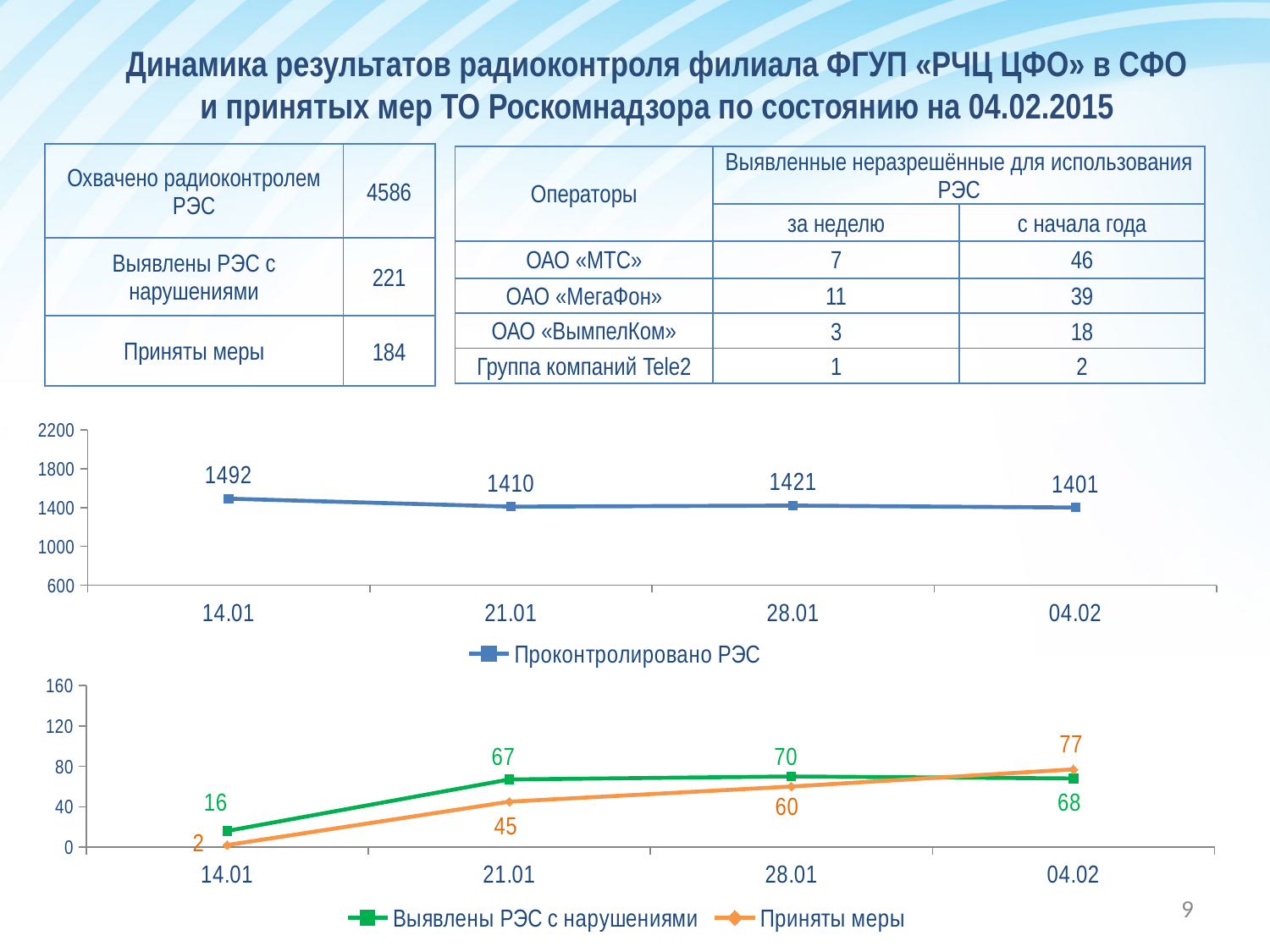
What kind of chart is the upper chart? Line chart In the lower chart, which is larger on 04.02: Выявлены РЭС с нарушениями or Приняты меры? Приняты меры In the upper chart, what is the value of Проконтролировано РЭС on 14.01? 1492 In the upper chart, what is the value of Проконтролировано РЭС on 04.02? 1401 In the lower chart, what is the value of Приняты меры on 21.01? 45 In the upper chart, what is the difference between the values on 14.01 and 21.01? 82 In the lower chart, on which date is Приняты меры highest? 04.02 In the upper chart, on which date is Проконтролировано РЭС highest? 14.01 In the lower chart, what is the difference between Выявлены РЭС с нарушениями and Приняты меры on 14.01? 14 How many series does the legend of the lower chart list? 2 In the lower chart, what is the value of Выявлены РЭС с нарушениями on 28.01? 70 In the upper chart, on which date is Проконтролировано РЭС lowest? 04.02